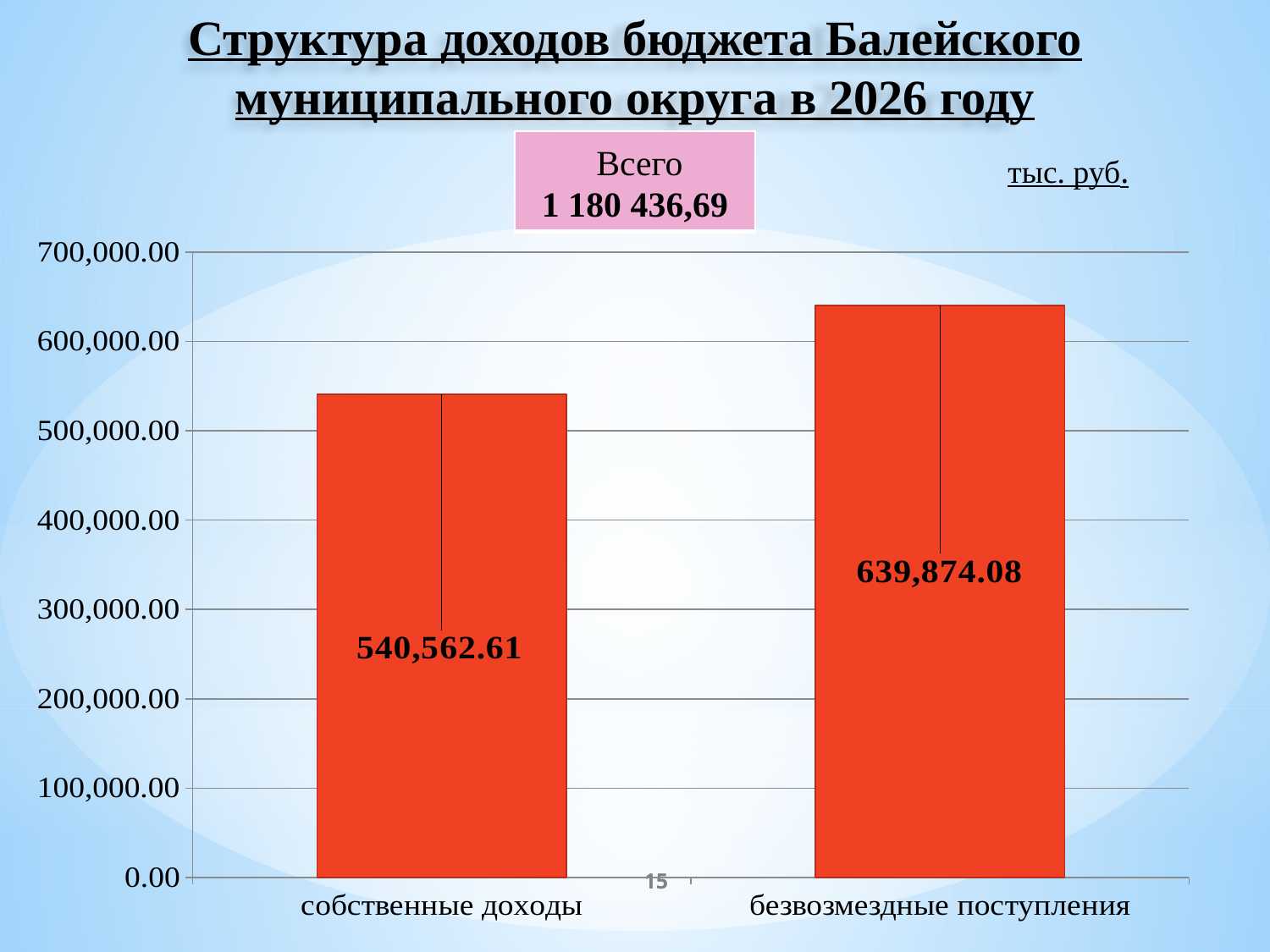
What is the value for собственные доходы? 540,562.61 Is the value for безвозмездные поступления greater or less than 700,000.00? less Is the value for собственные доходы greater or less than 500,000.00? greater How many categories are shown in the chart? 2 What is the difference between безвозмездные поступления and собственные доходы? 99,311.47 What is the value for безвозмездные поступления? 639,874.08 What kind of chart is shown on the slide? bar chart What unit is indicated for the chart values? тыс. руб. What total (Всего) is shown above the chart? 1 180 436,69 Which category has the lowest value? собственные доходы Which is larger, собственные доходы or безвозмездные поступления? безвозмездные поступления Which category has the highest value? безвозмездные поступления